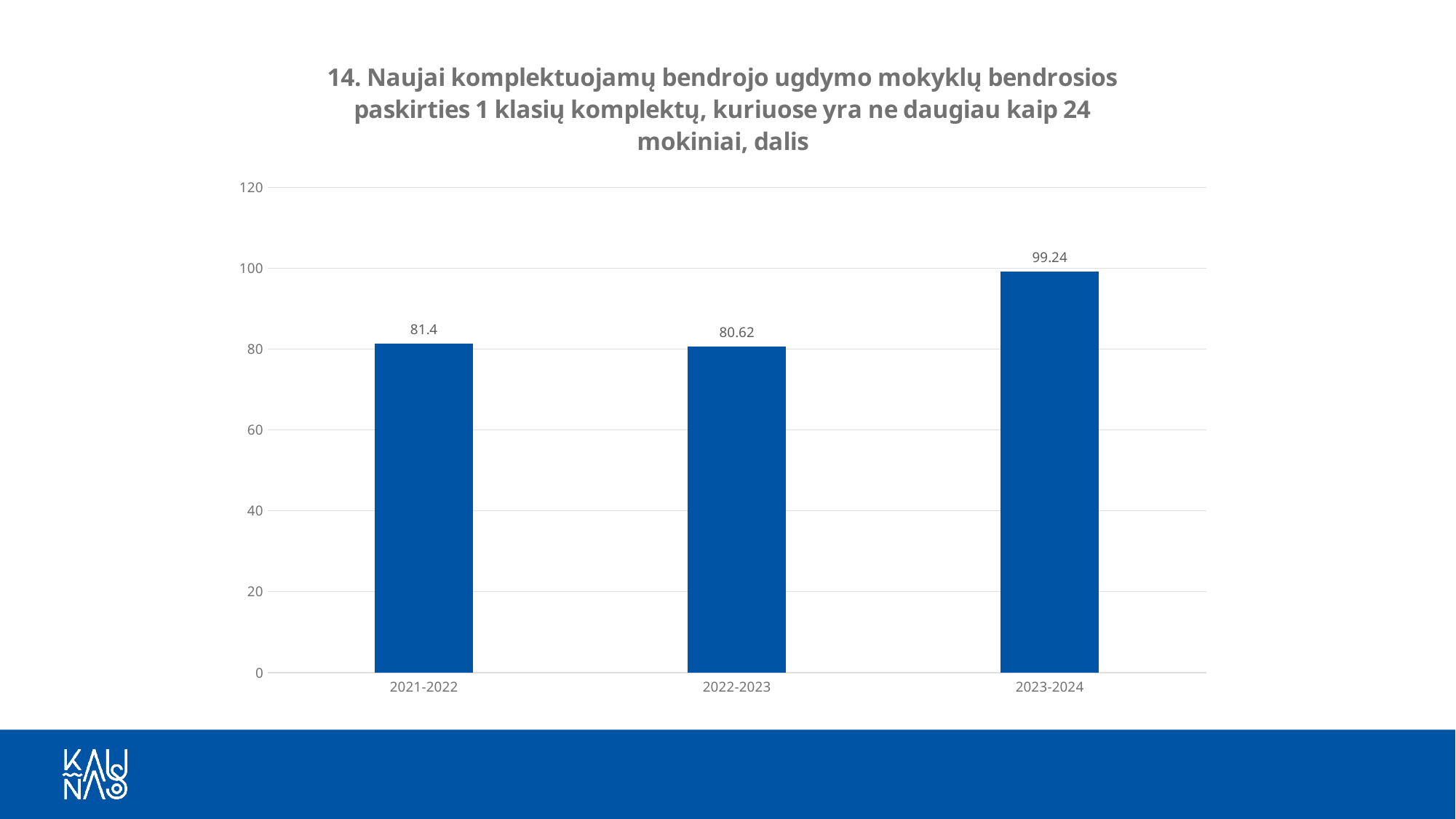
What is the value for 2023-2024? 99.24 Which school year has the highest value? 2023-2024 What is the difference between the values for 2021-2022 and 2022-2023? 0.78 Which school year has the lowest value? 2022-2023 Is the value for 2023-2024 greater or less than 80? greater How many school years are shown on the x axis? 3 What is the value for 2022-2023? 80.62 Which is larger, the value for 2023-2024 or the value for 2022-2023? 2023-2024 What is the value for 2021-2022? 81.4 What kind of chart is shown on the slide? Bar chart What is the highest value shown on the y axis? 120 What is the difference between the values for 2023-2024 and 2021-2022? 17.84